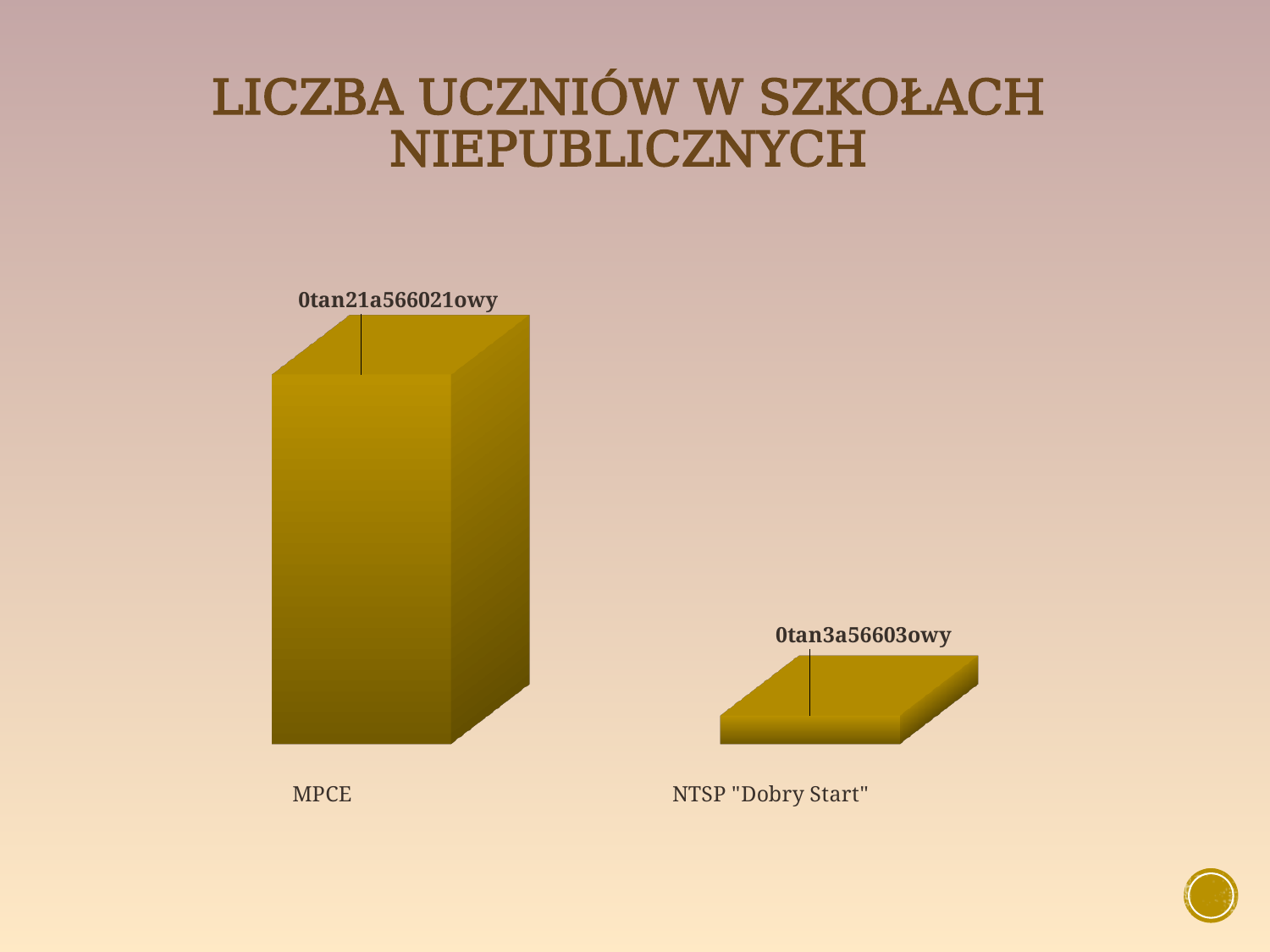
How many categories are plotted in the chart? 2 Do the values fall or rise from the left category to the right category? fall What kind of chart is shown on the slide? bar chart What is the title of the chart on the slide? LICZBA UCZNIÓW W SZKOŁACH NIEPUBLICZNYCH Which category has the lowest value in the chart? NTSP "Dobry Start" Which is larger, the value for MPCE or the value for NTSP "Dobry Start"? MPCE Which category has the highest value in the chart? MPCE What colour are the bars in the chart? gold